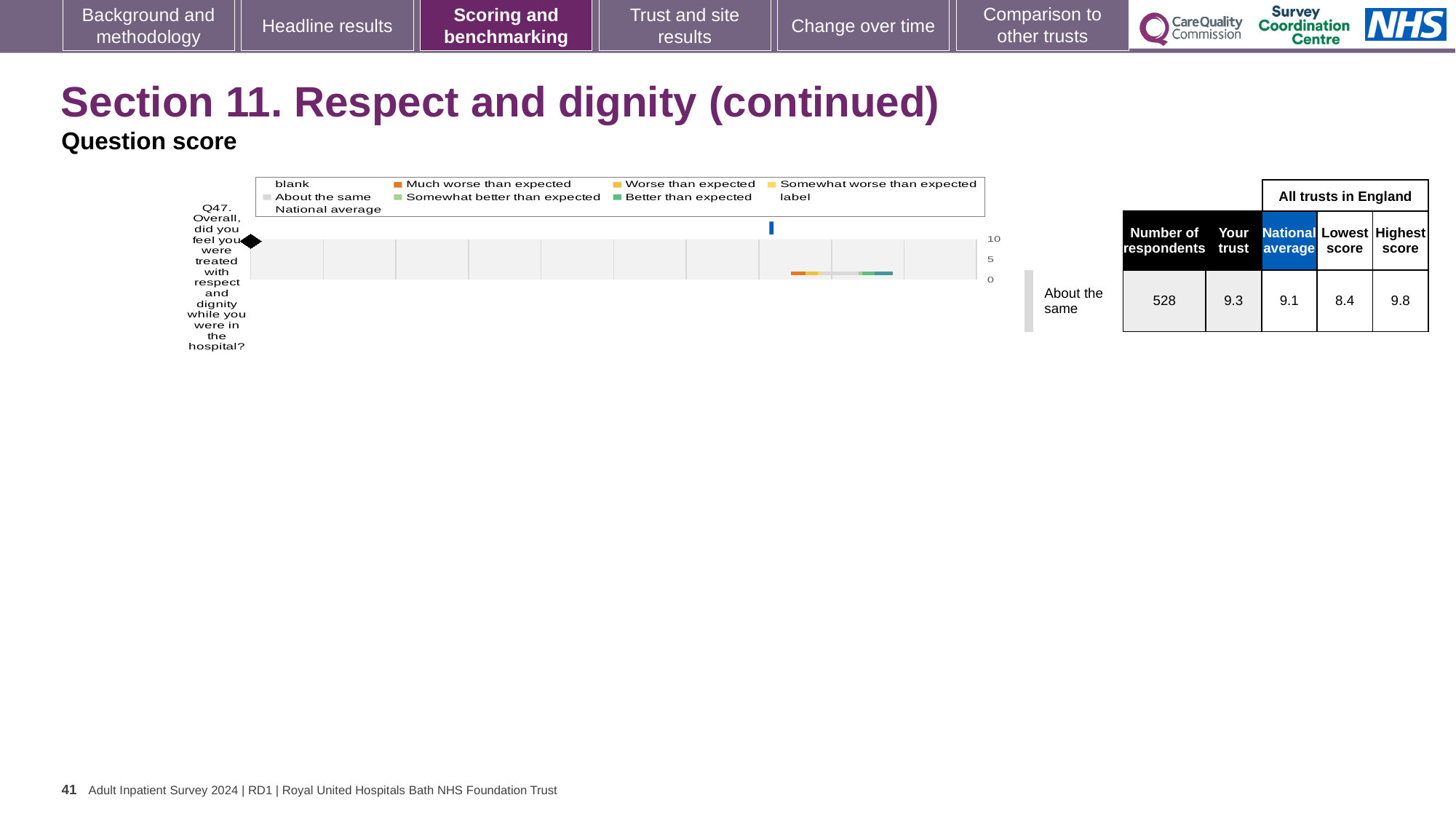
How many entries does the chart's legend list? 9 What is the highest tick value shown on the chart's value axis? 10 In the table beside the chart, how many respondents answered Q47? 528 In the table beside the chart, what is the 'Your trust' score for Q47? 9.3 How many question categories are plotted on the chart? 1 What kind of chart is shown on the slide? bar chart Which is larger for Q47, the 'Your trust' score or the National average? Your trust In the table beside the chart, what is the National average score for Q47? 9.1 In the table beside the chart, what is the Lowest score among all trusts in England for Q47? 8.4 What is the difference between the Highest score and the Lowest score for Q47 in the table beside the chart? 1.4 Which question number is labelled on the chart's category axis? Q47 In the table beside the chart, what is the Highest score among all trusts in England for Q47? 9.8